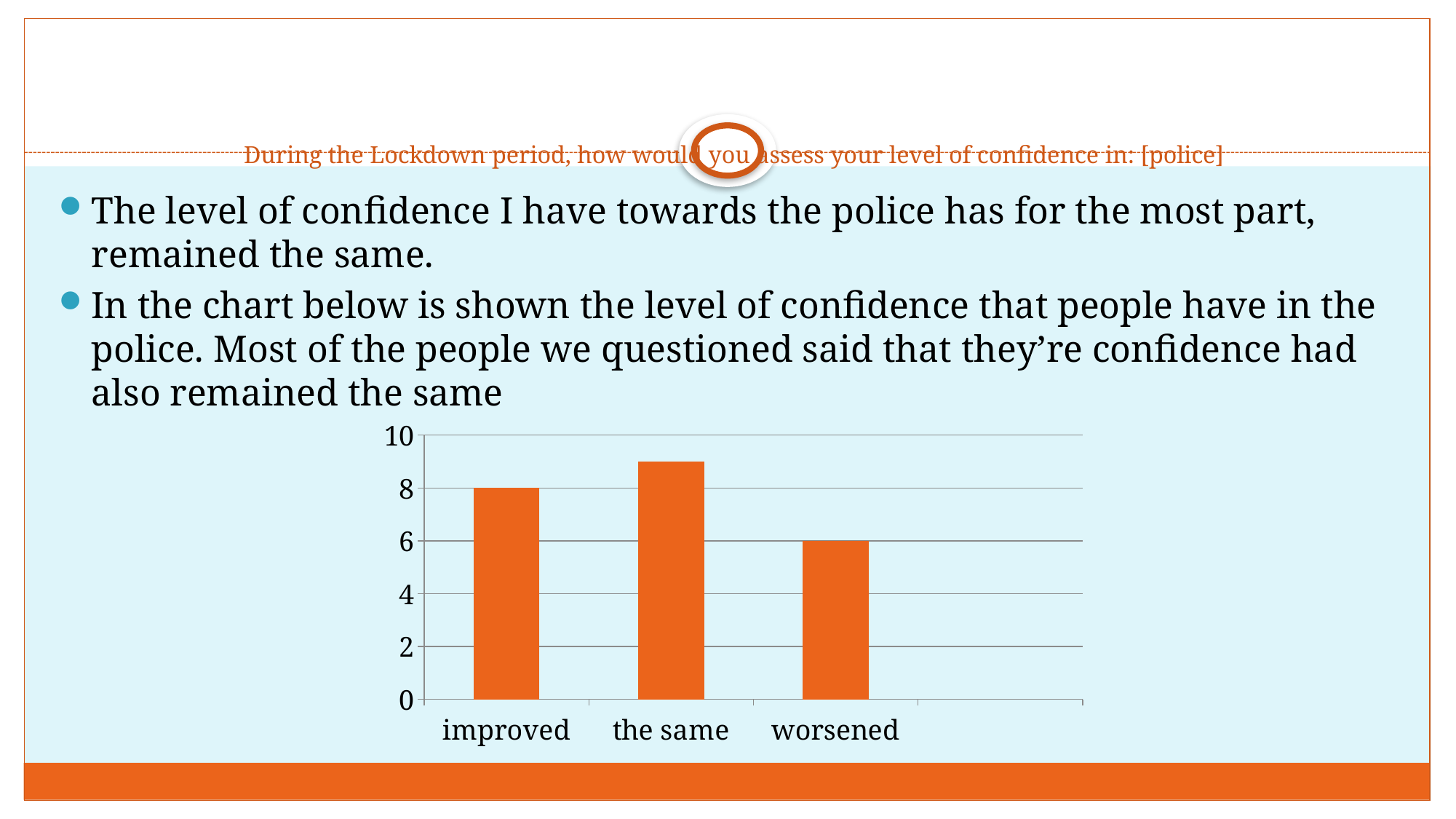
What is the difference between the values for "improved" and "worsened"? 2 Which category has the highest bar in the chart? the same What is the value for "improved" in the chart? 8 What is the highest value shown on the chart's vertical axis? 10 How many categories are shown on the x axis of the chart? 3 What colour are the bars in the chart? orange Is the value for "the same" greater or less than 8? greater Which category has the lowest bar in the chart? worsened Which is larger, the value for "improved" or the value for "worsened"? improved What type of chart is shown on the slide? bar chart What is the value for "worsened" in the chart? 6 Is the value for "the same" greater or less than 10? less